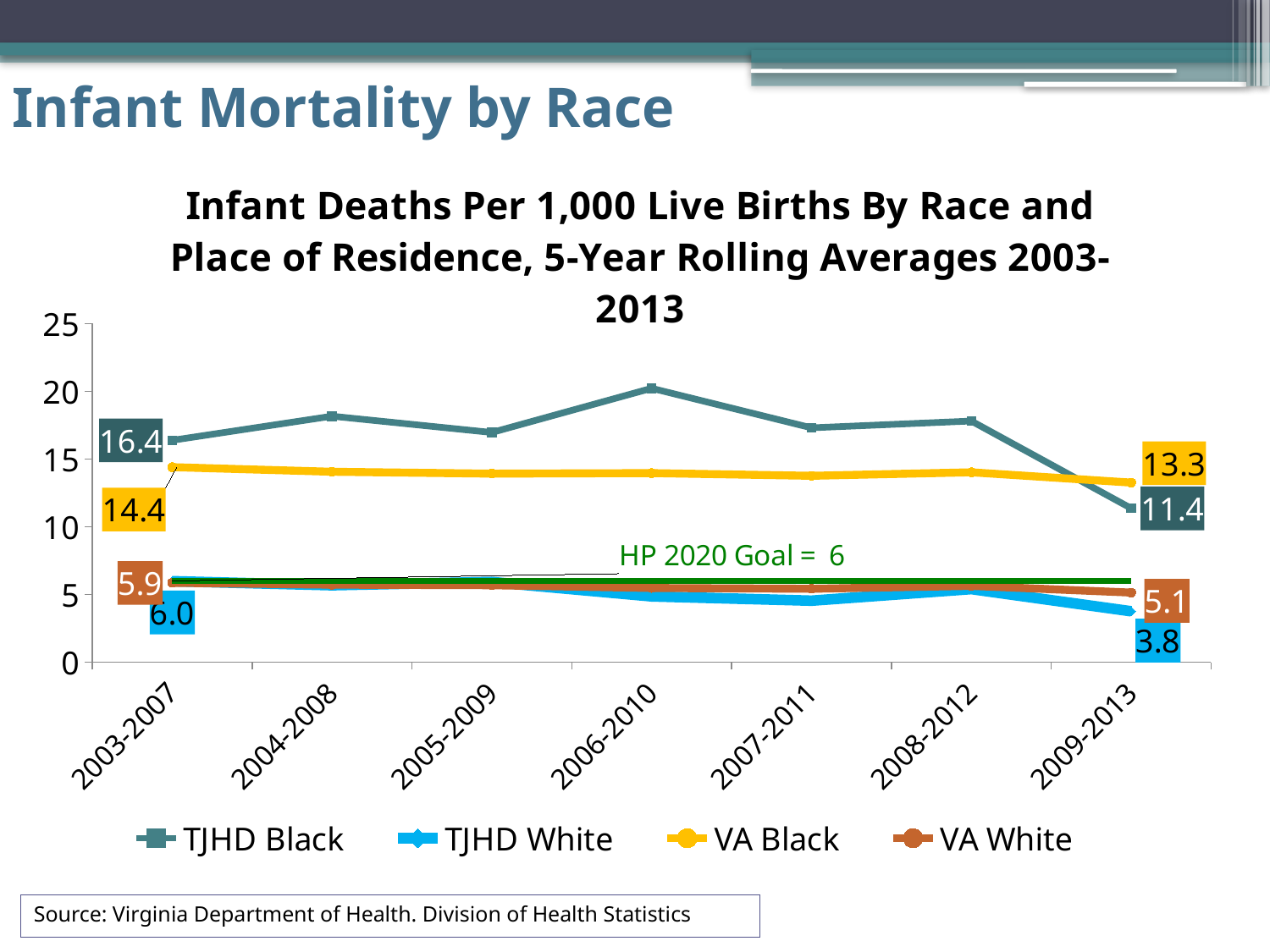
Is the value for TJHD Black in 2006-2010 greater or less than 15? greater What is the value for VA Black in 2009-2013? 13.3 What is the HP 2020 Goal shown on the chart? 6 What kind of chart is this? line chart What is the value for VA White in 2003-2007? 5.9 How many 5-year periods are shown on the x axis? 7 How many series does the legend list? 4 What is the value for TJHD White in 2009-2013? 3.8 What is the value for TJHD Black in 2003-2007? 16.4 In which period is the TJHD Black value highest? 2006-2010 In 2009-2013, which is larger: VA Black or TJHD Black? VA Black By how much did the TJHD Black value fall from 2003-2007 (16.4) to 2009-2013 (11.4)? 5.0